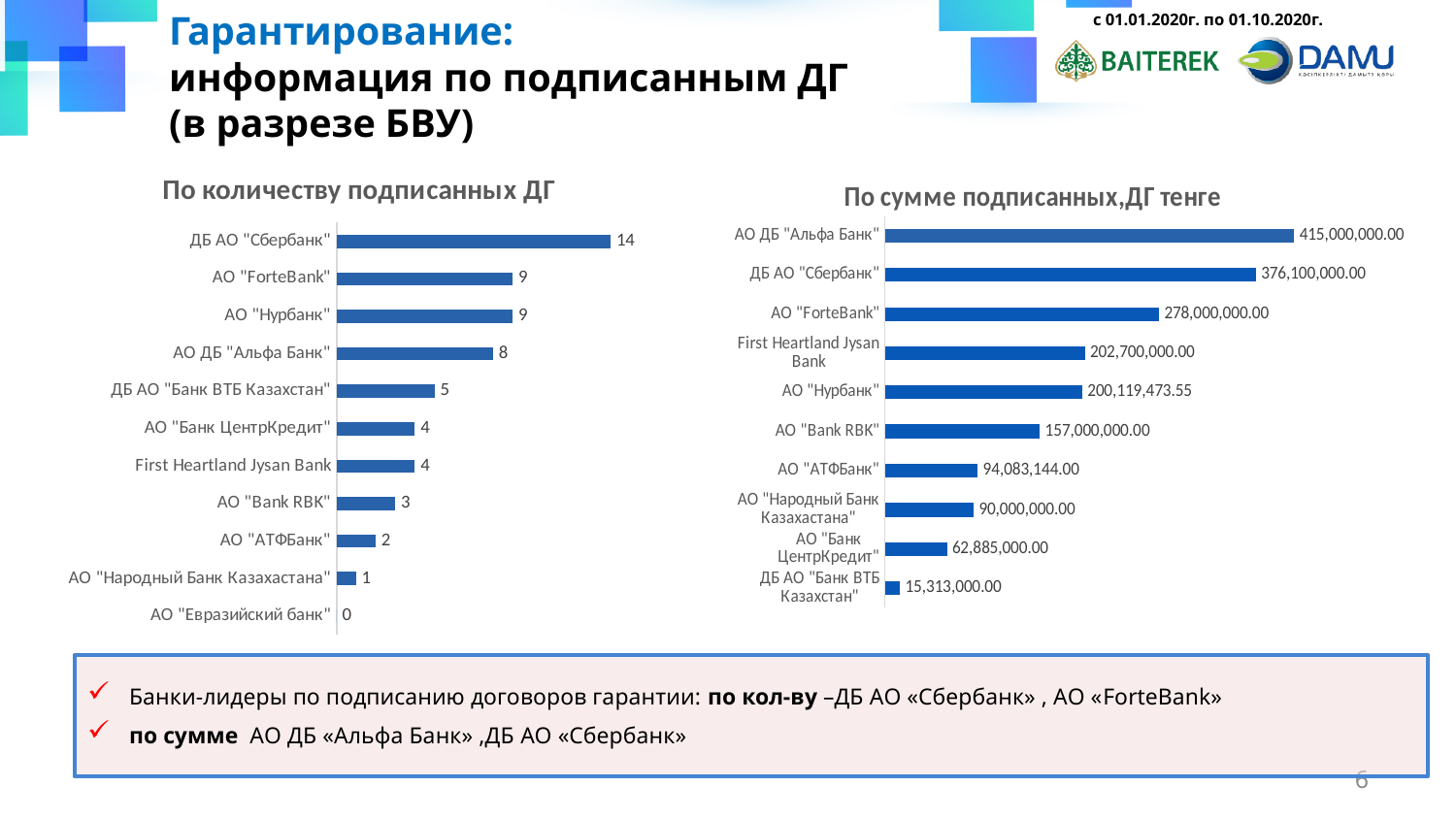
In the chart "По сумме подписанных,ДГ тенге", what is the difference between АО ДБ "Альфа Банк" and ДБ АО "Сбербанк"? 38,900,000.00 In the chart "По сумме подписанных,ДГ тенге", which bank has the highest value? АО ДБ "Альфа Банк" In the chart "По количеству подписанных ДГ", what is the value for ДБ АО "Сбербанк"? 14 What type of chart is "По количеству подписанных ДГ"? bar chart In the chart "По количеству подписанных ДГ", which bank has the lowest value? АО "Евразийский банк" In the chart "По сумме подписанных,ДГ тенге", which is larger: АО "АТФБанк" or АО "Народный Банк Казахастана"? АО "АТФБанк" In the chart "По количеству подписанных ДГ", what is the difference between ДБ АО "Сбербанк" and АО ДБ "Альфа Банк"? 6 In the chart "По количеству подписанных ДГ", which bank has the highest value? ДБ АО "Сбербанк" In the chart "По количеству подписанных ДГ", how many banks are shown? 11 In the chart "По сумме подписанных,ДГ тенге", how many banks are shown? 10 In the chart "По сумме подписанных,ДГ тенге", which bank has the lowest value? ДБ АО "Банк ВТБ Казахстан" In the chart "По сумме подписанных,ДГ тенге", what is the value for АО "Нурбанк"? 200,119,473.55